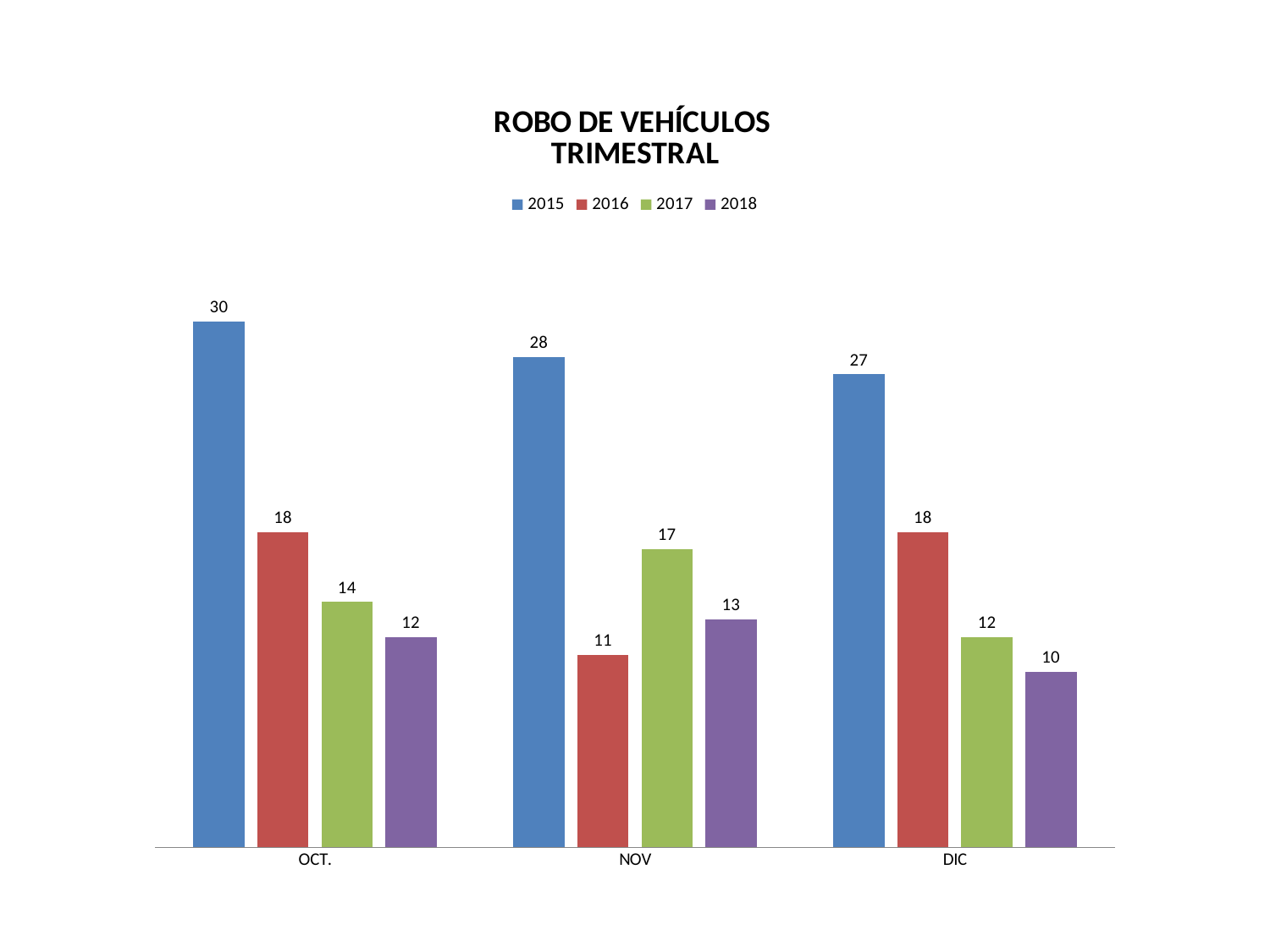
What kind of chart is shown on the slide? Bar chart How many months are shown on the x axis? 3 What is the value for 2015 in OCT.? 30 Which is larger in NOV: the value for 2017 or the value for 2018? 2017 How many series does the legend list? 4 What is the value for 2018 in DIC? 10 What is the value for 2017 in NOV? 17 Which month has the highest value for 2015? OCT. What is the value for 2016 in NOV? 11 What is the difference between the 2015 and 2016 values in OCT.? 12 Do the values for 2015 rise or fall from OCT. to DIC? Fall Which month has the lowest value for 2016? NOV